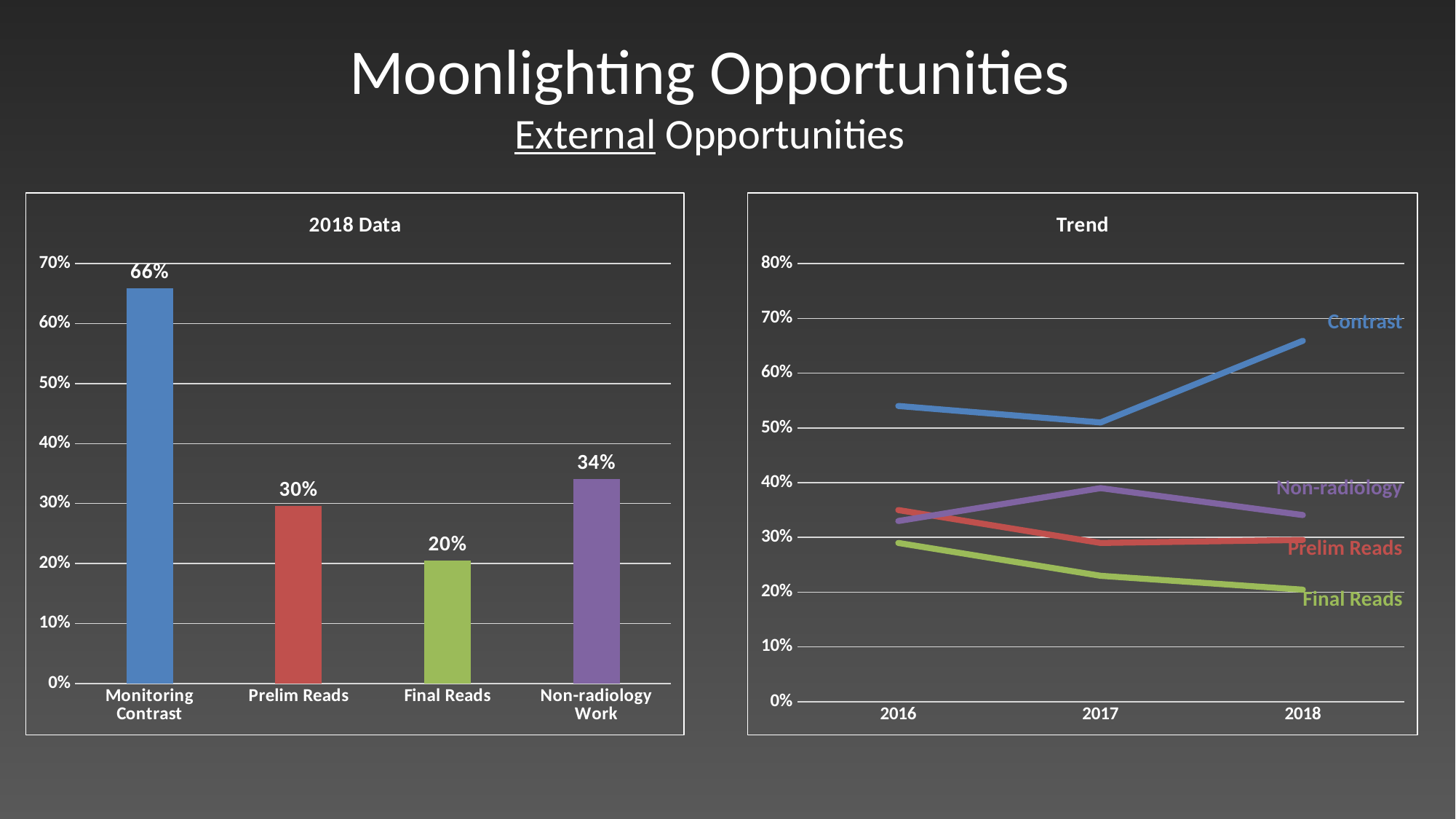
In the "2018 Data" chart, which category has the lowest value? Final Reads In the "2018 Data" chart, what is the difference between Monitoring Contrast and Prelim Reads? 36% What kind of chart is the "Trend" chart? Line chart In the "2018 Data" chart, which category has the highest value? Monitoring Contrast How many categories are shown in the "2018 Data" chart? 4 In the "Trend" chart, does the Final Reads line rise or fall from 2016 to 2018? Fall How many series are plotted in the "Trend" chart? 4 In the "2018 Data" chart, which is larger, Prelim Reads or Non-radiology Work? Non-radiology Work In the "Trend" chart, is the value for Contrast in 2018 greater or less than 60%? greater In the "2018 Data" chart, what is the value for Non-radiology Work? 34% What kind of chart is the "2018 Data" chart? Bar chart In the "2018 Data" chart, what is the value for Monitoring Contrast? 66%